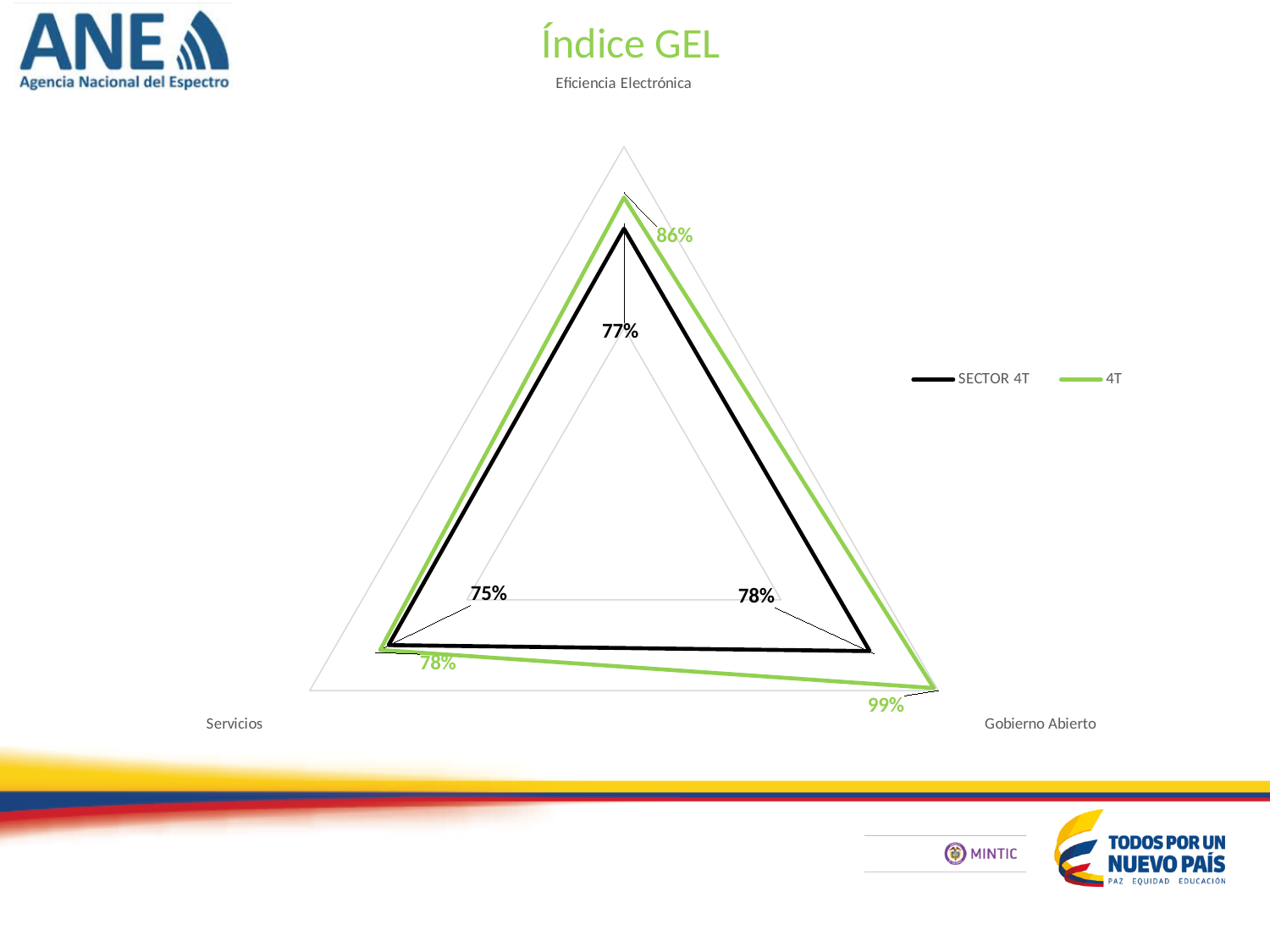
What is the title of the chart? Índice GEL What is the difference between the 4T and SECTOR 4T values for Gobierno Abierto? 21% What kind of chart is shown on the slide? Radar chart For which category does 4T have its highest value? Gobierno Abierto What is the value of SECTOR 4T for Servicios? 75% How many categories (axes) does the radar chart have? 3 What is the value of 4T for Gobierno Abierto? 99% How many series does the legend list? 2 What is the value of 4T for Servicios? 78% What is the value of SECTOR 4T for Eficiencia Electrónica? 77% For which category does SECTOR 4T have its lowest value? Servicios Which series has the larger value for Eficiencia Electrónica, SECTOR 4T or 4T? 4T